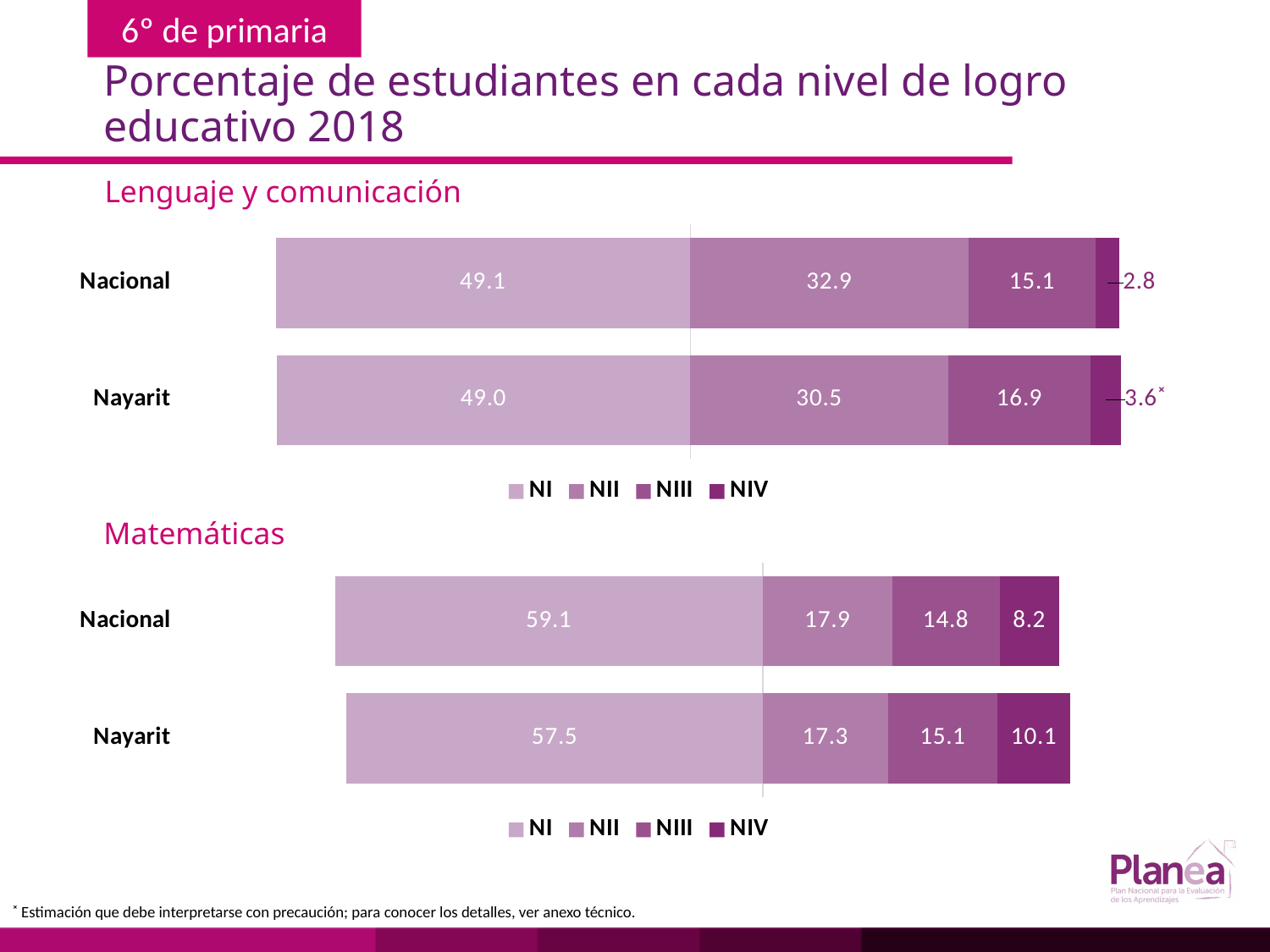
What kind of chart is the Matemáticas chart? Stacked bar chart In the Lenguaje y comunicación chart, what is the NII value for Nacional? 32.9 In the Lenguaje y comunicación chart, what is the NIV value for Nayarit? 3.6 In the Matemáticas chart, what is the difference between the NIV values for Nayarit and Nacional? 1.9 How many series does the legend of the Lenguaje y comunicación chart list? 4 In the Lenguaje y comunicación chart, which is larger: the NIII value for Nacional or for Nayarit? Nayarit In the Lenguaje y comunicación chart, which level has the lowest value for Nacional? NIV In the Matemáticas chart, what is the NIII value for Nacional? 14.8 In the Matemáticas chart, what is the NI value for Nayarit? 57.5 How many categories are shown in the Lenguaje y comunicación chart? 2 In the Matemáticas chart, which level has the highest value for Nacional? NI In the Matemáticas chart, what is the total of the Nayarit bar? 100.0